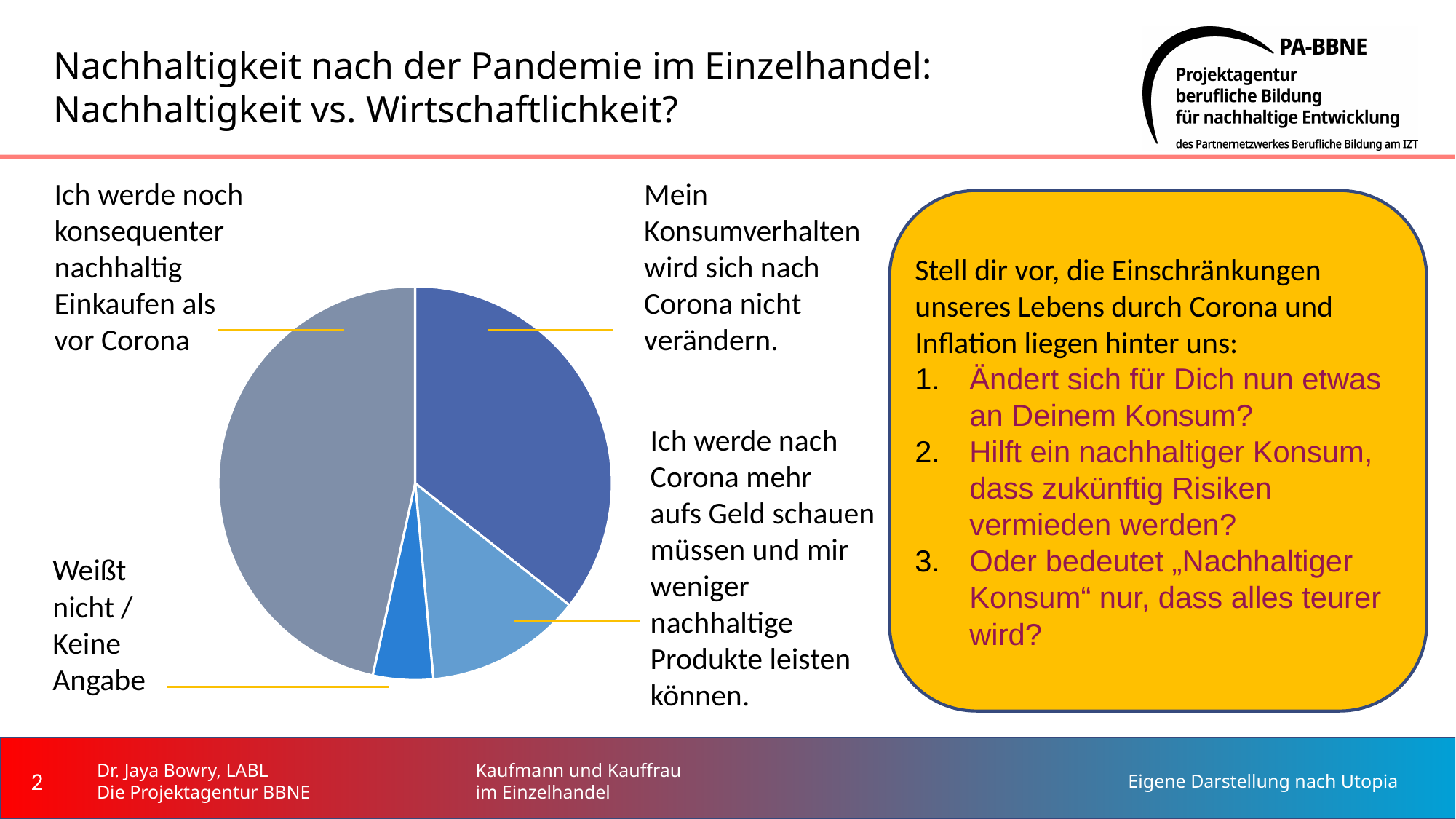
Which slice is larger: "Mein Konsumverhalten wird sich nach Corona nicht verändern" or "Ich werde nach Corona mehr aufs Geld schauen müssen und mir weniger nachhaltige Produkte leisten können"? Mein Konsumverhalten wird sich nach Corona nicht verändern What kind of chart is shown on the slide? pie chart Which slice is larger: "Mein Konsumverhalten wird sich nach Corona nicht verändern" or "Weißt nicht / Keine Angabe"? Mein Konsumverhalten wird sich nach Corona nicht verändern Which category has the largest slice in the pie chart? Ich werde noch konsequenter nachhaltig Einkaufen als vor Corona What colour is the slice for "Weißt nicht / Keine Angabe" in the pie chart? bright blue Which slice is larger: "Ich werde nach Corona mehr aufs Geld schauen müssen und mir weniger nachhaltige Produkte leisten können" or "Weißt nicht / Keine Angabe"? Ich werde nach Corona mehr aufs Geld schauen müssen und mir weniger nachhaltige Produkte leisten können What colour is the slice for "Ich werde noch konsequenter nachhaltig Einkaufen als vor Corona" in the pie chart? grey How many slices does the pie chart have? 4 Which category has the smallest slice in the pie chart? Weißt nicht / Keine Angabe